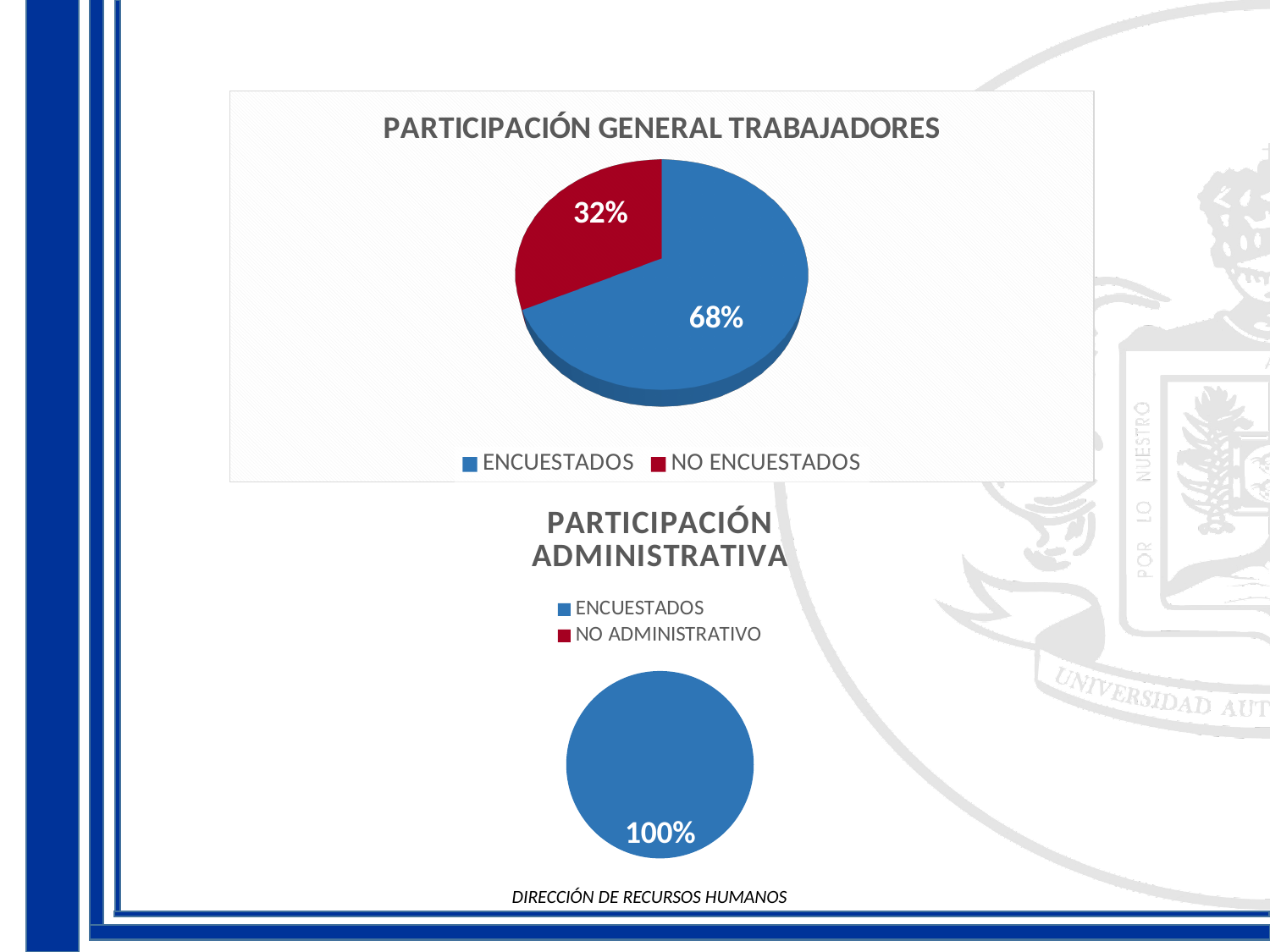
In the 'PARTICIPACIÓN GENERAL TRABAJADORES' chart, which category has the largest slice? ENCUESTADOS How many categories does the legend of the 'PARTICIPACIÓN GENERAL TRABAJADORES' chart list? 2 In the 'PARTICIPACIÓN GENERAL TRABAJADORES' chart, what is the difference in percentage points between ENCUESTADOS and NO ENCUESTADOS? 36 What kind of chart is 'PARTICIPACIÓN GENERAL TRABAJADORES'? Pie chart In the 'PARTICIPACIÓN ADMINISTRATIVA' chart, what share is shown for ENCUESTADOS? 100% In the 'PARTICIPACIÓN GENERAL TRABAJADORES' chart, what share of the pie is NO ENCUESTADOS? 32% How many entries does the legend of the 'PARTICIPACIÓN ADMINISTRATIVA' chart list? 2 In the 'PARTICIPACIÓN GENERAL TRABAJADORES' chart, which is larger, ENCUESTADOS or NO ENCUESTADOS? ENCUESTADOS In the 'PARTICIPACIÓN GENERAL TRABAJADORES' chart, what share of the pie is ENCUESTADOS? 68% What kind of chart is 'PARTICIPACIÓN ADMINISTRATIVA'? Pie chart In the 'PARTICIPACIÓN GENERAL TRABAJADORES' chart, which category has the smallest slice? NO ENCUESTADOS In the 'PARTICIPACIÓN GENERAL TRABAJADORES' chart, what colour is the NO ENCUESTADOS slice? Red